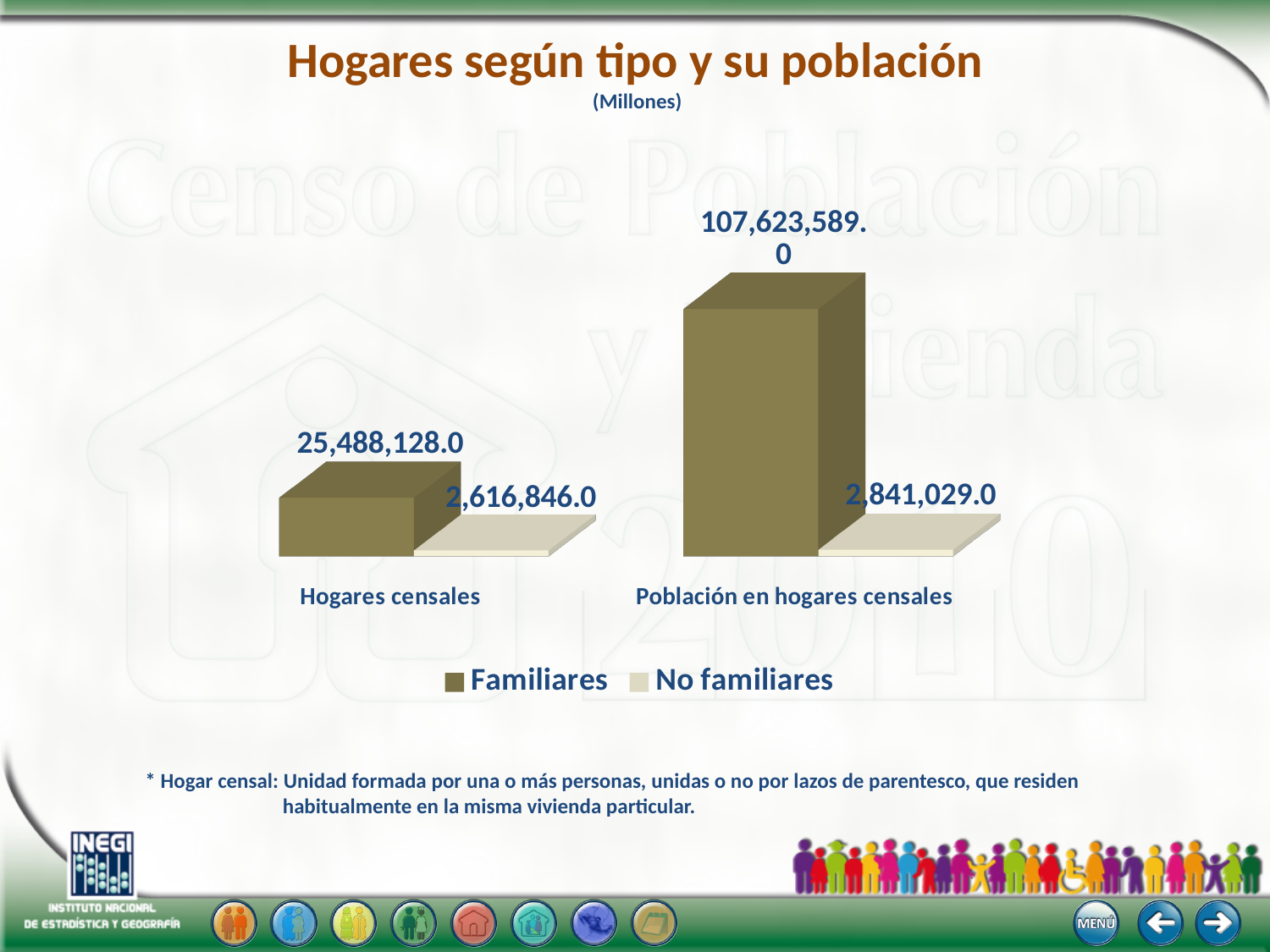
How many categories are shown on the x axis of the chart? 2 Which bar has the highest value on the chart? Familiares, Población en hogares censales What type of chart is shown on the slide? Bar chart What is the value for Familiares in the Hogares censales category? 25,488,128.0 What is the value for No familiares in the Población en hogares censales category? 2,841,029.0 What is the value for No familiares in the Hogares censales category? 2,616,846.0 How many series does the legend list? 2 What is the difference between the Familiares and No familiares values in the Hogares censales category? 22,871,282.0 What is the difference between the Familiares and No familiares values in the Población en hogares censales category? 104,782,560.0 Which is larger: the No familiares value for Hogares censales or the No familiares value for Población en hogares censales? Población en hogares censales What is the value for Familiares in the Población en hogares censales category? 107,623,589.0 Which bar has the lowest value on the chart? No familiares, Hogares censales